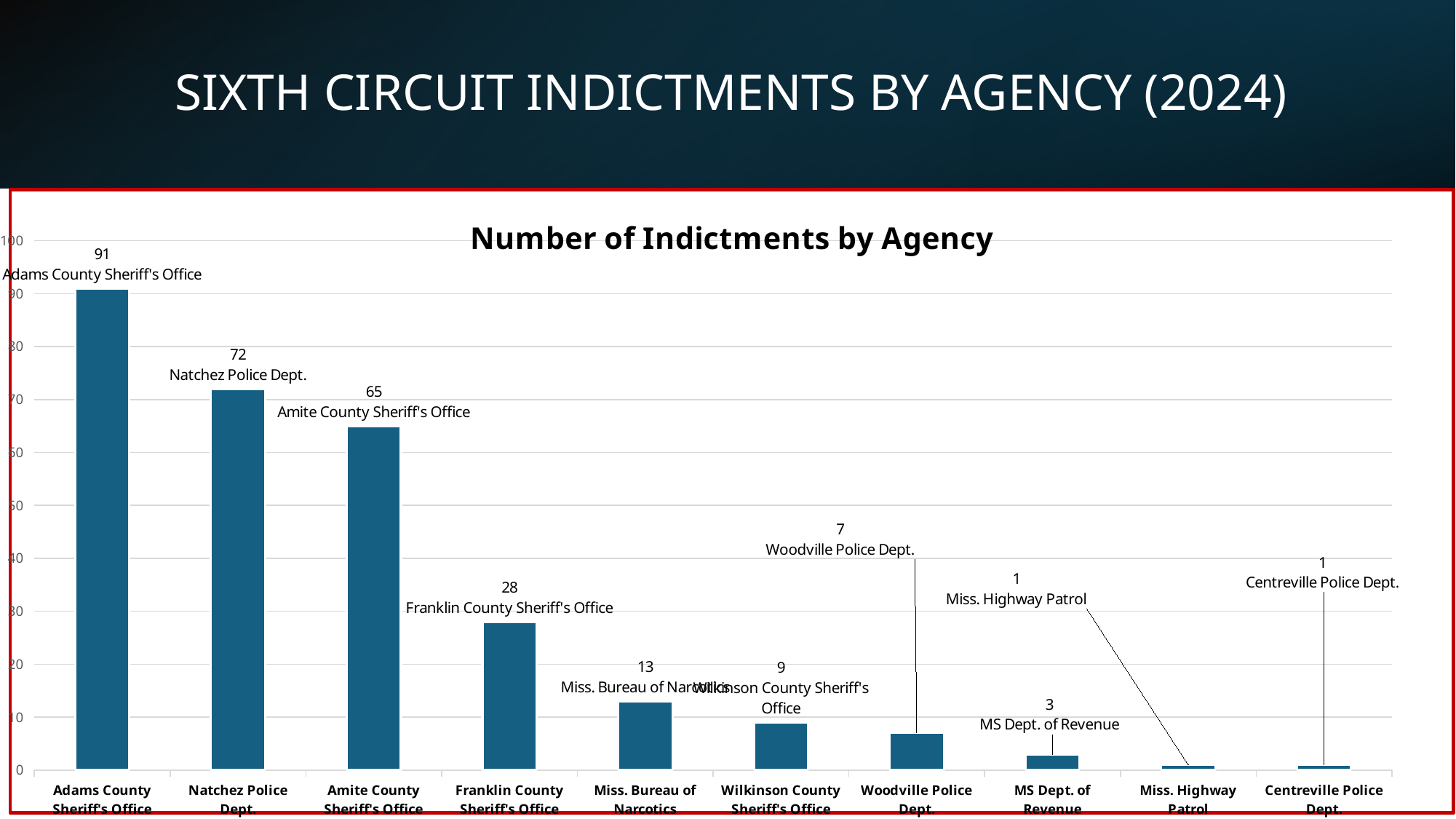
What is the title of the chart? Number of Indictments by Agency What is the difference in indictments between Natchez Police Dept. and Franklin County Sheriff's Office? 44 What is the number of indictments for MS Dept. of Revenue? 3 What is the number of indictments for Natchez Police Dept.? 72 What type of chart is shown on the slide? Bar chart How many agencies are shown in the chart? 10 What is the number of indictments for Franklin County Sheriff's Office? 28 Which agency has the highest number of indictments? Adams County Sheriff's Office Is the value for Amite County Sheriff's Office greater or less than 60? greater Which has more indictments, Woodville Police Dept. or Wilkinson County Sheriff's Office? Wilkinson County Sheriff's Office What is the difference in indictments between Adams County Sheriff's Office and Amite County Sheriff's Office? 26 What is the number of indictments for Miss. Bureau of Narcotics? 13